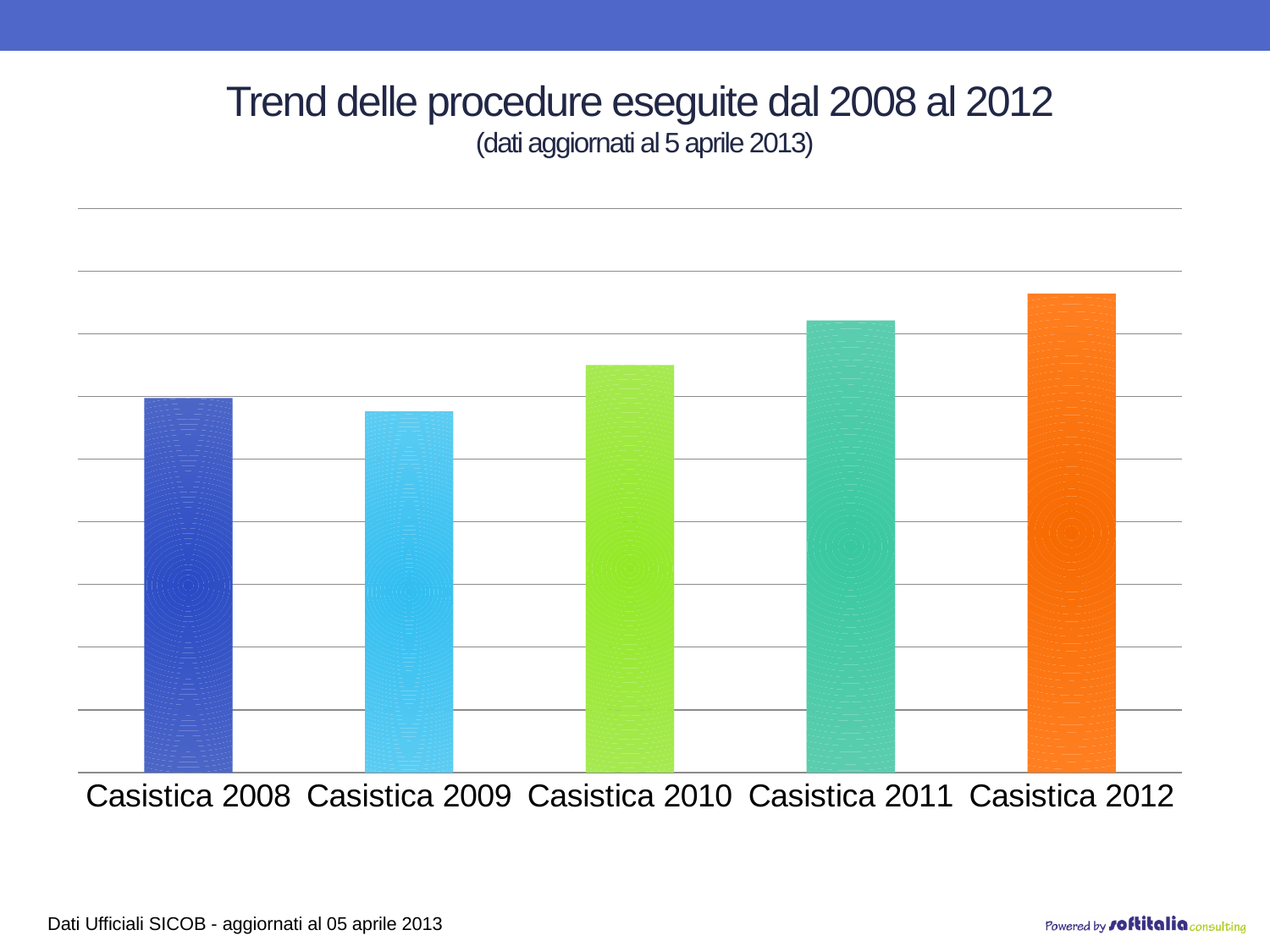
Does the value rise or fall from Casistica 2008 to Casistica 2009? Fall How many categories (bars) are plotted in the chart? 5 Do the values generally rise or fall from Casistica 2009 to Casistica 2012? Rise Which is larger, the value for Casistica 2010 or Casistica 2011? Casistica 2011 What is the title of the chart on the slide? Trend delle procedure eseguite dal 2008 al 2012 What kind of chart is shown on the slide? Bar chart Which is larger, the value for Casistica 2011 or Casistica 2012? Casistica 2012 Which is larger, the value for Casistica 2009 or Casistica 2010? Casistica 2010 What colour is the bar for Casistica 2012? Orange Which category has the highest bar? Casistica 2012 Which category has the lowest bar? Casistica 2009